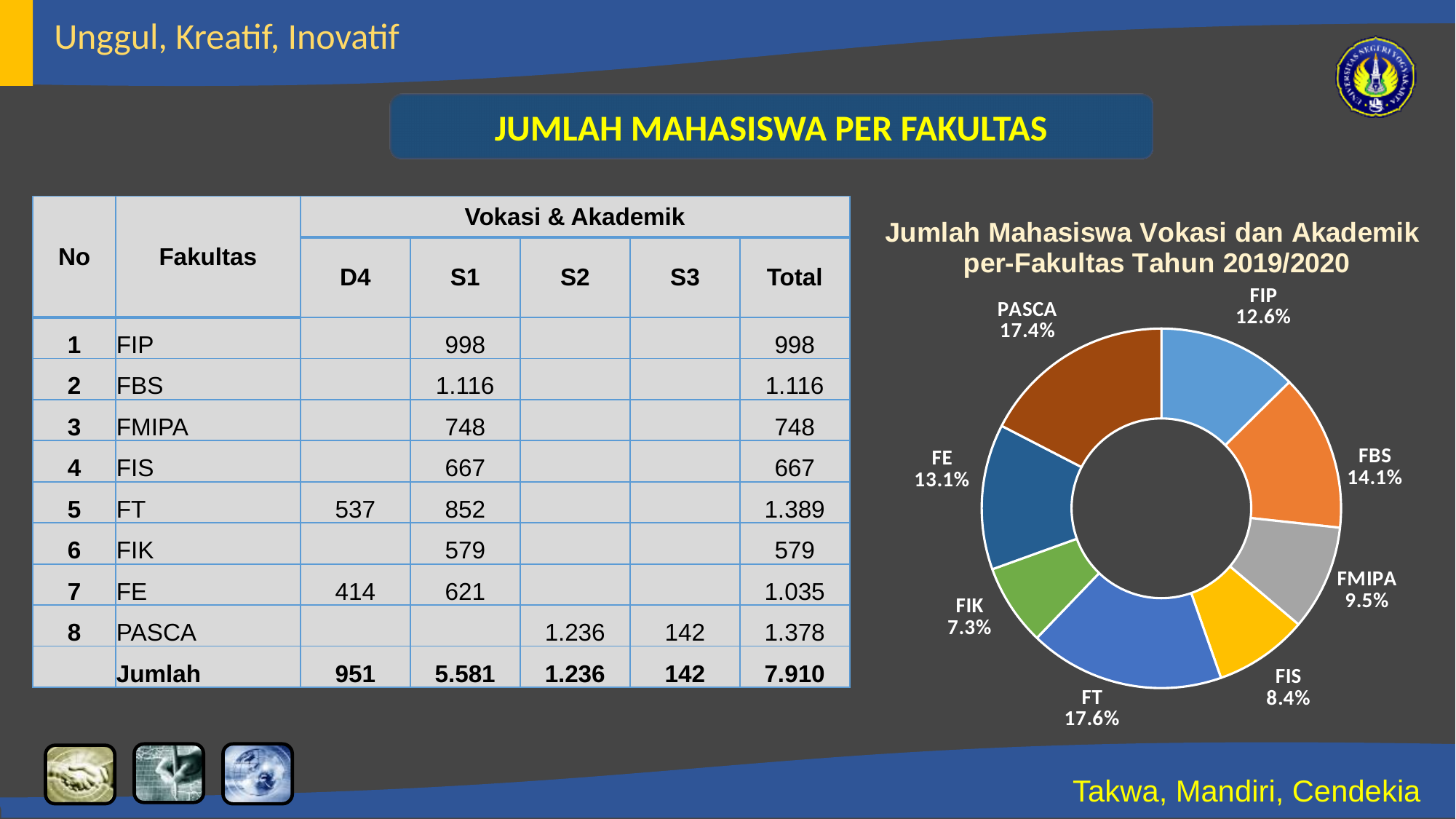
What percentage is shown for FMIPA in the doughnut chart? 9.5% What percentage is shown for FIS in the doughnut chart? 8.4% What is the difference in percentage points between FBS and FIP in the doughnut chart? 1.5 What is the title of the chart on the slide? Jumlah Mahasiswa Vokasi dan Akademik per-Fakultas Tahun 2019/2020 What percentage share does FIP have in the doughnut chart? 12.6% How many faculties (slices) are shown in the doughnut chart? 8 What is the difference in percentage points between FT and FIK in the doughnut chart? 10.3 What kind of chart is shown on the right side of the slide? doughnut chart Which faculty has the smallest share in the doughnut chart? FIK Which faculty has the largest share in the doughnut chart? FT What percentage is shown for PASCA in the doughnut chart? 17.4% In the doughnut chart, which has a larger share, FE or FBS? FBS